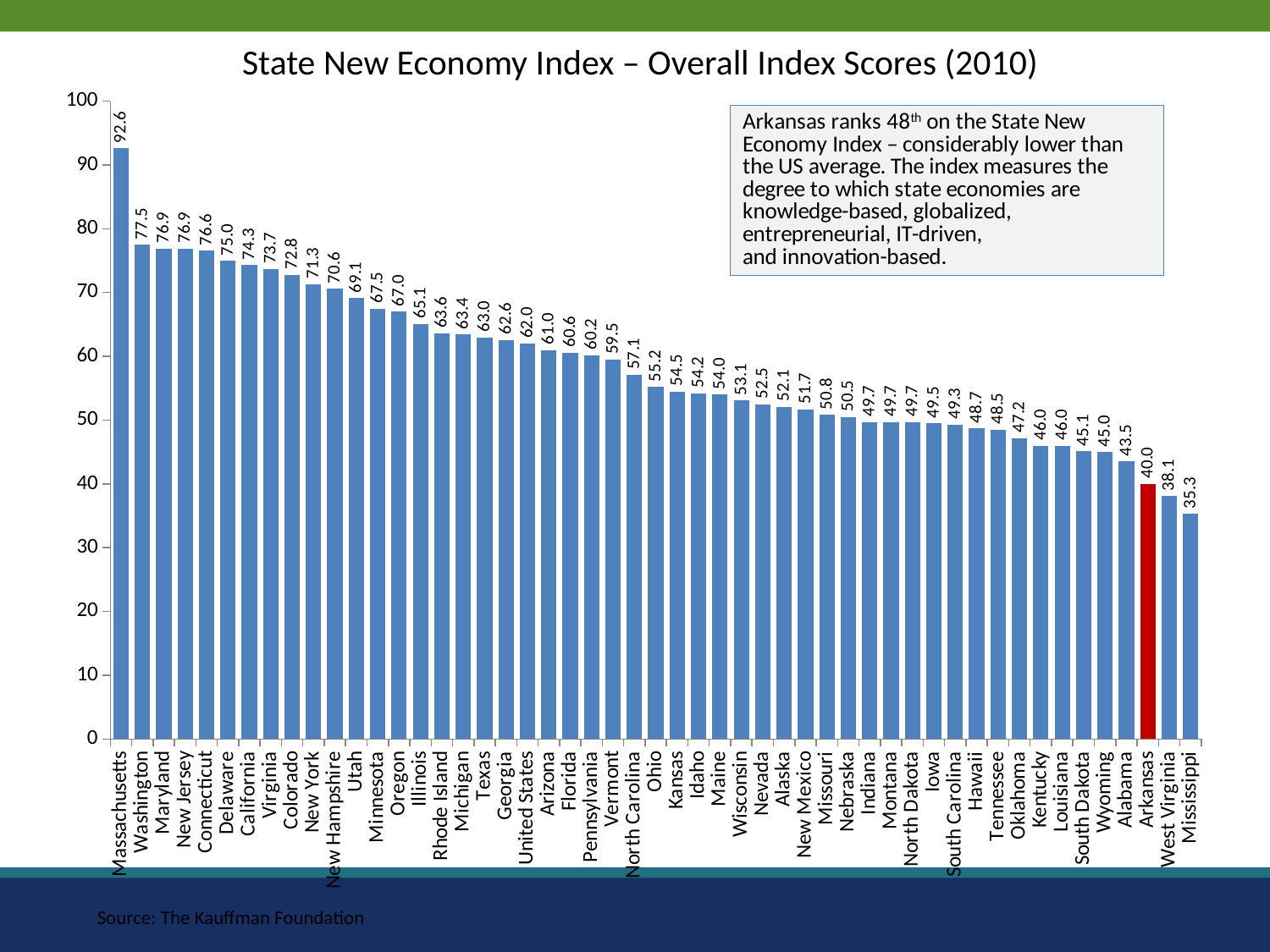
Do the index scores rise or fall moving from left to right along the x axis? Fall Which state has the highest overall index score? Massachusetts Which bar is highlighted in red on the chart? Arkansas What is the overall index score for Arkansas? 40.0 What is the overall index score for Texas? 63.0 What is the overall index score for Massachusetts? 92.6 What type of chart is shown on the slide? Bar chart Which has a higher overall index score, Alabama or Arkansas? Alabama What is the difference between the United States score and the Arkansas score? 22.0 Which state has the lowest overall index score? Mississippi What is the overall index score for the United States? 62.0 What is the difference between the Massachusetts score and the Washington score? 15.1